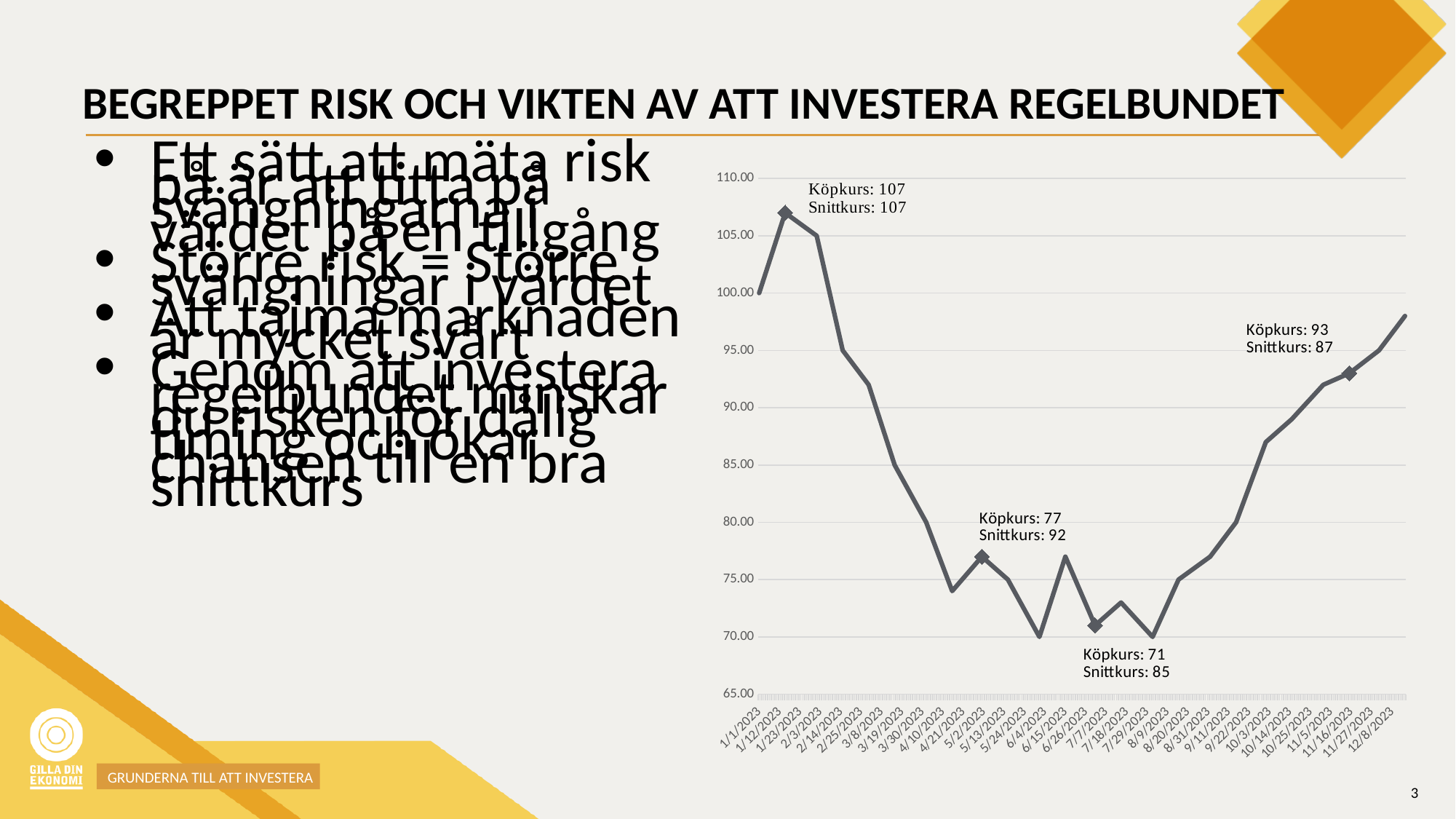
At the annotated point around 11/16/2023, which is larger, the Köpkurs or the Snittkurs? Köpkurs How many annotated Köpkurs/Snittkurs points are marked on the line? 4 Which annotated point has the lowest Köpkurs? Köpkurs: 71 (around 7/7/2023) Which annotated point has the highest Köpkurs? Köpkurs: 107 (around 1/23/2023) What kind of chart is shown on the slide? line chart What is the Snittkurs shown at the annotated point around 11/16/2023? 87 What is the Köpkurs shown at the annotated point around 7/7/2023? 71 What is the difference between the highest annotated Köpkurs (107) and the lowest annotated Köpkurs (71)? 36 What is the Köpkurs shown at the first annotated point (around 1/23/2023)? 107 What is the Snittkurs shown at the annotated point around 5/13/2023? 92 Is the value at the last date (12/8/2023) greater or less than 95? greater Is the value around 4/21/2023 greater or less than 75? less